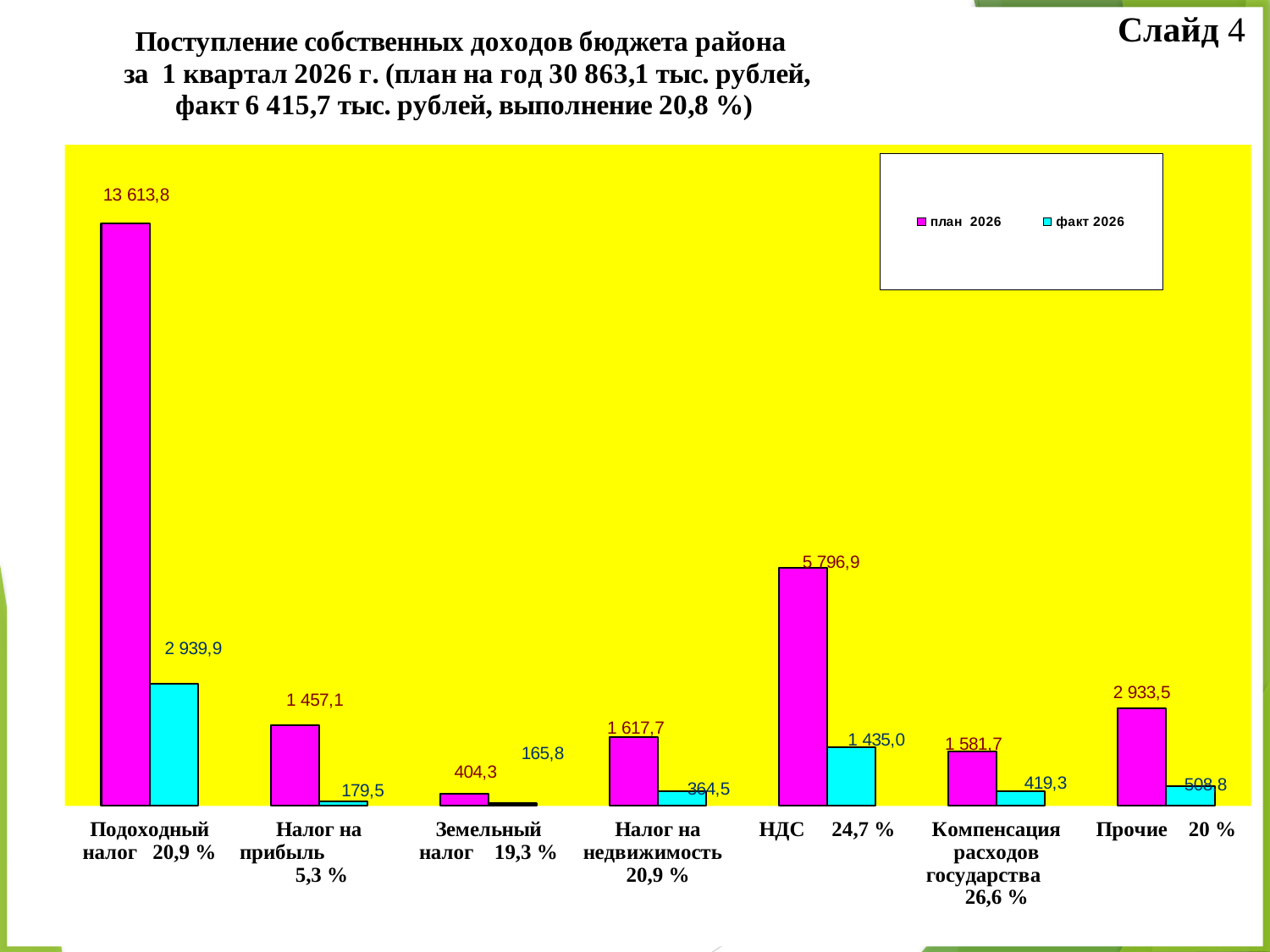
How many categories are shown on the x axis of the chart? 7 How many series does the legend list? 2 What is the факт 2026 value for Земельный налог? 165,8 What is the difference between the план 2026 and факт 2026 values for Подоходный налог? 10 673,9 What kind of chart is shown on the slide? Bar chart What is the факт 2026 value for НДС? 1 435,0 Which category has the highest план 2026 value? Подоходный налог Which category has the lowest план 2026 value? Земельный налог What is the факт 2026 value for Компенсация расходов государства? 419,3 What is the план 2026 value for Подоходный налог? 13 613,8 Which is larger: the план 2026 value for НДС or the план 2026 value for Прочие? НДС What is the план 2026 value for Прочие? 2 933,5